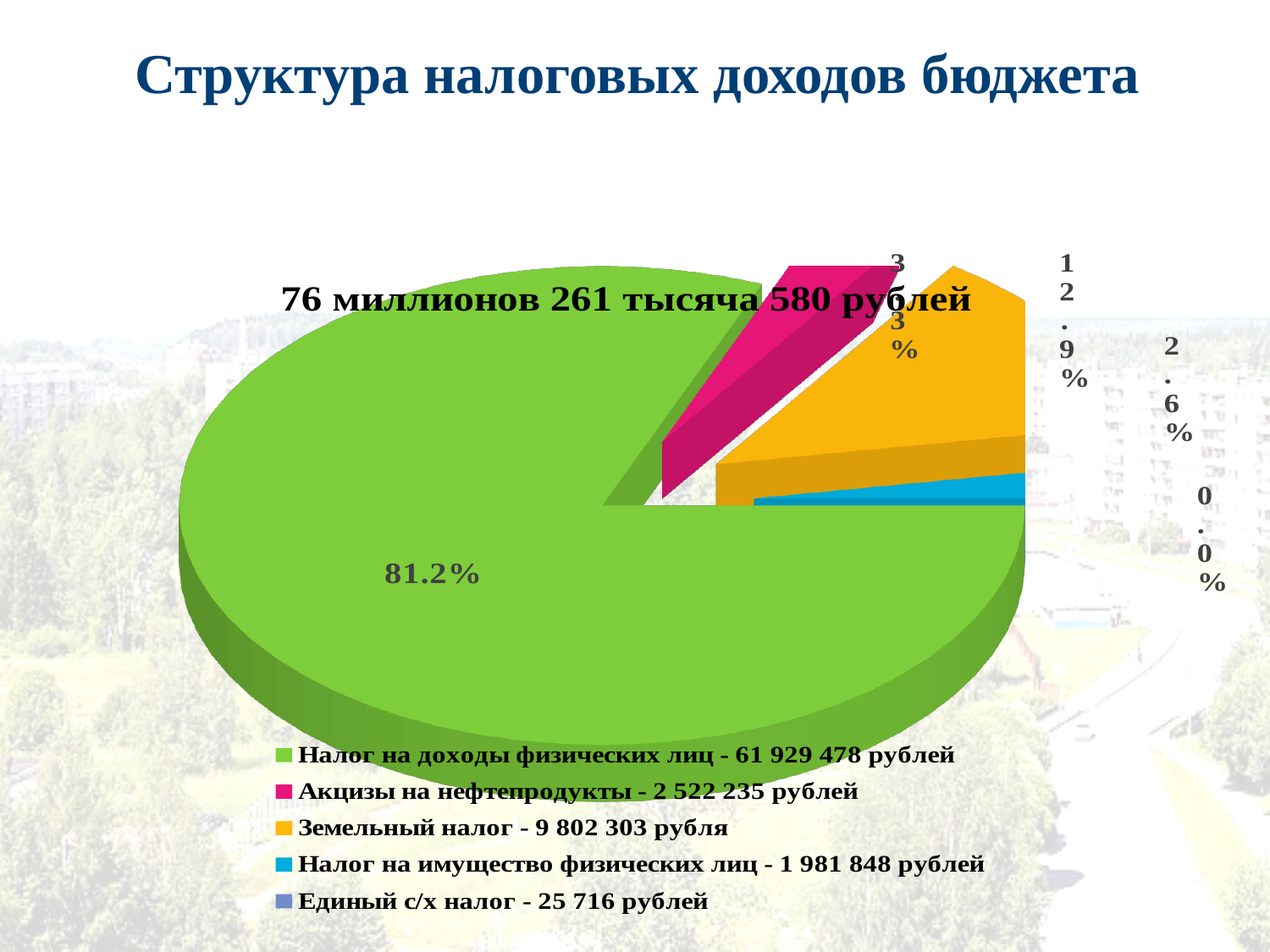
What kind of chart is shown on the slide? pie chart According to the legend, what is the amount for 'Земельный налог'? 9 802 303 рубля What is the title of the chart on the slide? 76 миллионов 261 тысяча 580 рублей Which is larger: the amount for 'Земельный налог' or for 'Акцизы на нефтепродукты'? Земельный налог Which category has the largest slice of the pie? Налог на доходы физических лиц What total amount is written above the pie chart? 76 миллионов 261 тысяча 580 рублей How many categories does the legend of the pie chart list? 5 Which category has the smallest slice of the pie? Единый с/х налог What share of the pie does 'Налог на имущество физических лиц' take? 2.6% According to the legend, what is the amount for 'Акцизы на нефтепродукты'? 2 522 235 рублей What share of the pie does 'Земельный налог' take? 12.9% What share of the pie does 'Налог на доходы физических лиц' take? 81.2%